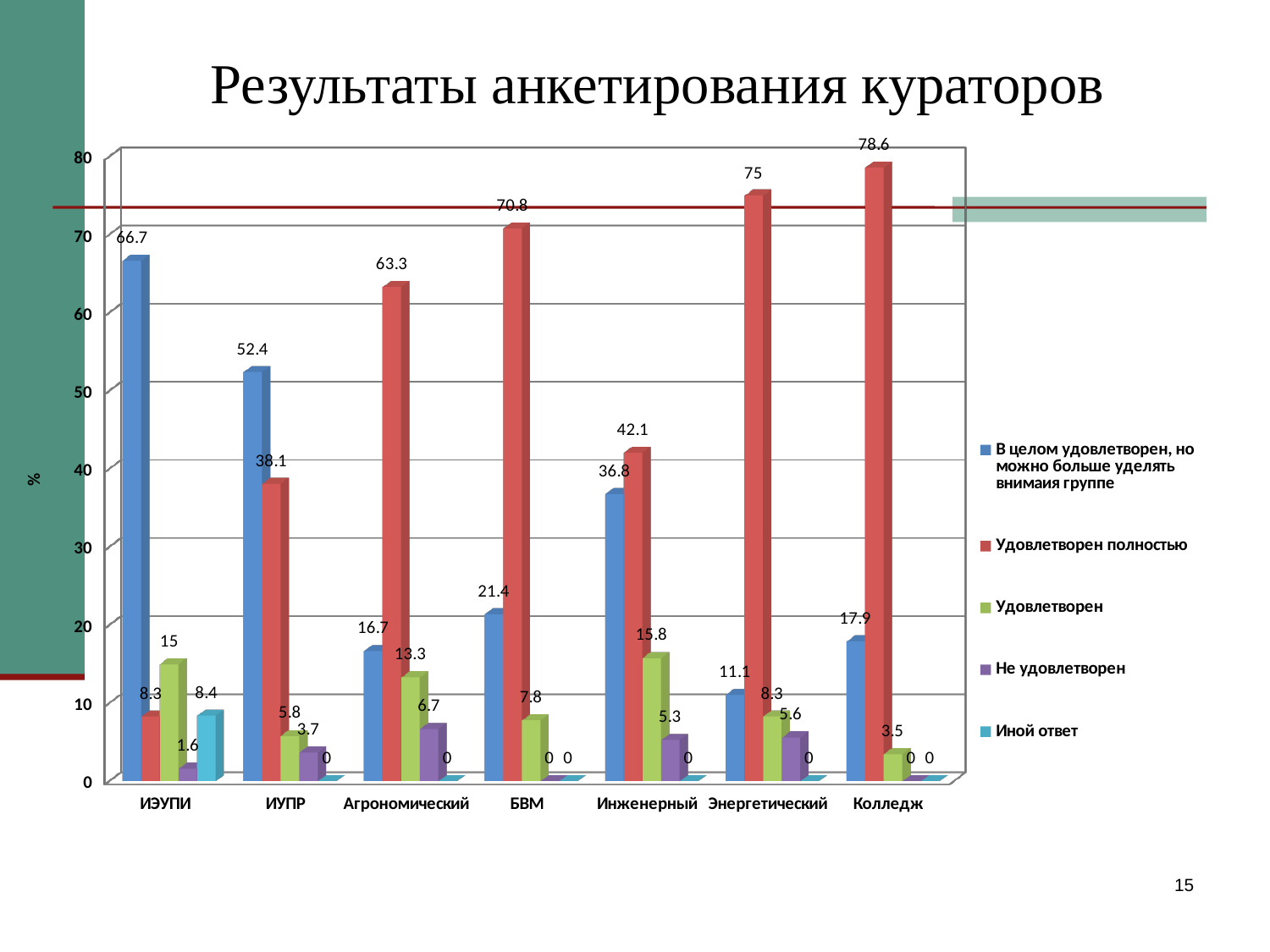
What is the title of the slide? Результаты анкетирования кураторов What is the value of 'В целом удовлетворен, но можно больше уделять внимаия группе' for ИЭУПИ? 66.7 How many series does the legend list? 5 What is the value of 'Удовлетворен' for Инженерный? 15.8 What is the difference between the 'Удовлетворен полностью' values for Колледж and Энергетический? 3.6 What is the value of 'Удовлетворен полностью' for Колледж? 78.6 Which category has the highest value for 'Удовлетворен полностью'? Колледж Which category has the lowest value for 'В целом удовлетворен, но можно больше уделять внимаия группе'? Энергетический How many categories are shown on the x axis? 7 What kind of chart is shown on the slide? Bar chart For ИУПР, which is larger: 'В целом удовлетворен, но можно больше уделять внимаия группе' or 'Удовлетворен полностью'? В целом удовлетворен, но можно больше уделять внимаия группе What is the value of 'Не удовлетворен' for Агрономический? 6.7